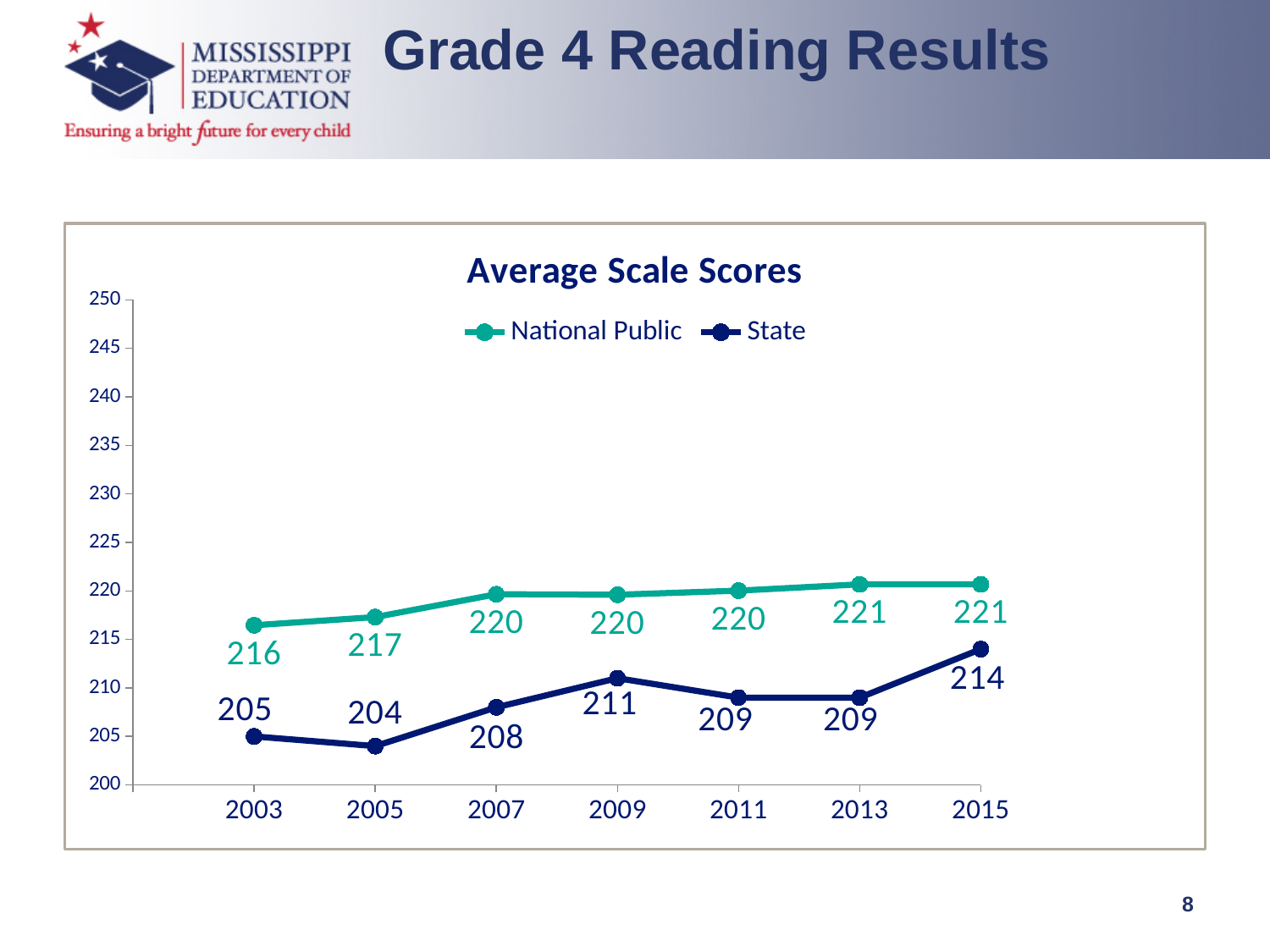
In which year is the State average scale score lowest? 2005 What is the National Public average scale score in 2003? 216 What is the State average scale score in 2015? 214 Which series has the higher score in 2011, National Public or State? National Public How many series does the legend list? 2 In which year is the State average scale score highest? 2015 How many years are plotted on the x axis? 7 What is the title of the chart? Average Scale Scores What kind of chart is shown on the slide? Line chart What is the difference between the National Public and State scores in 2003? 11 What is the State average scale score in 2009? 211 What is the difference between the National Public and State scores in 2015? 7